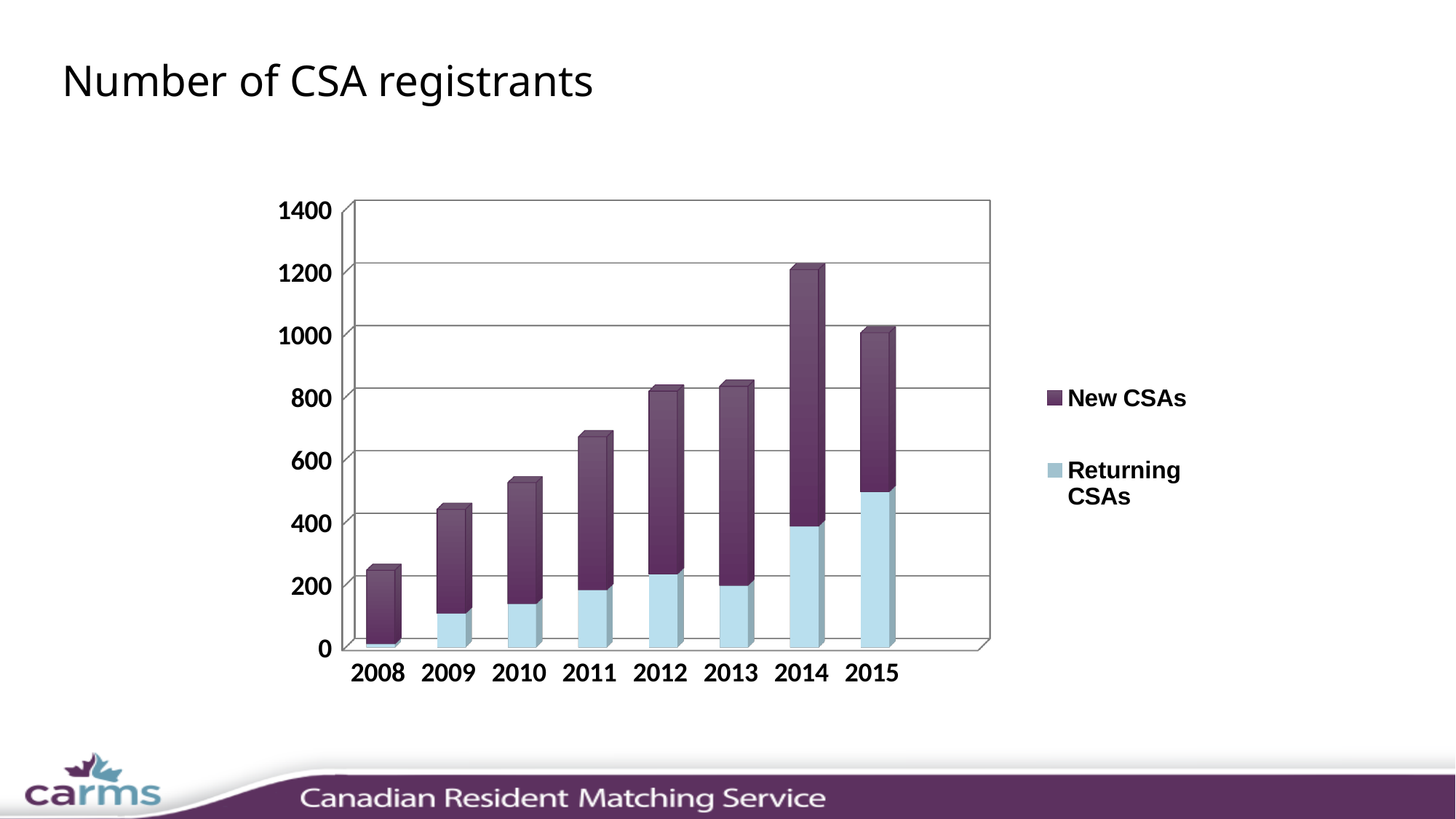
How many years are shown on the x axis of the chart? 8 Which year has the lowest total number of CSA registrants? 2008 Which year has the highest total number of CSA registrants? 2014 What kind of chart is shown on the slide? Stacked bar chart How many series does the chart's legend list? 2 Which year has the larger total number of CSA registrants, 2014 or 2015? 2014 Is the total number of CSA registrants in 2014 greater or less than 1000? greater Is the total number of CSA registrants in 2012 greater or less than 600? greater What colour represents New CSAs in the chart? Purple Which year has more Returning CSAs, 2014 or 2015? 2015 Is the total number of CSA registrants in 2008 greater or less than 400? less